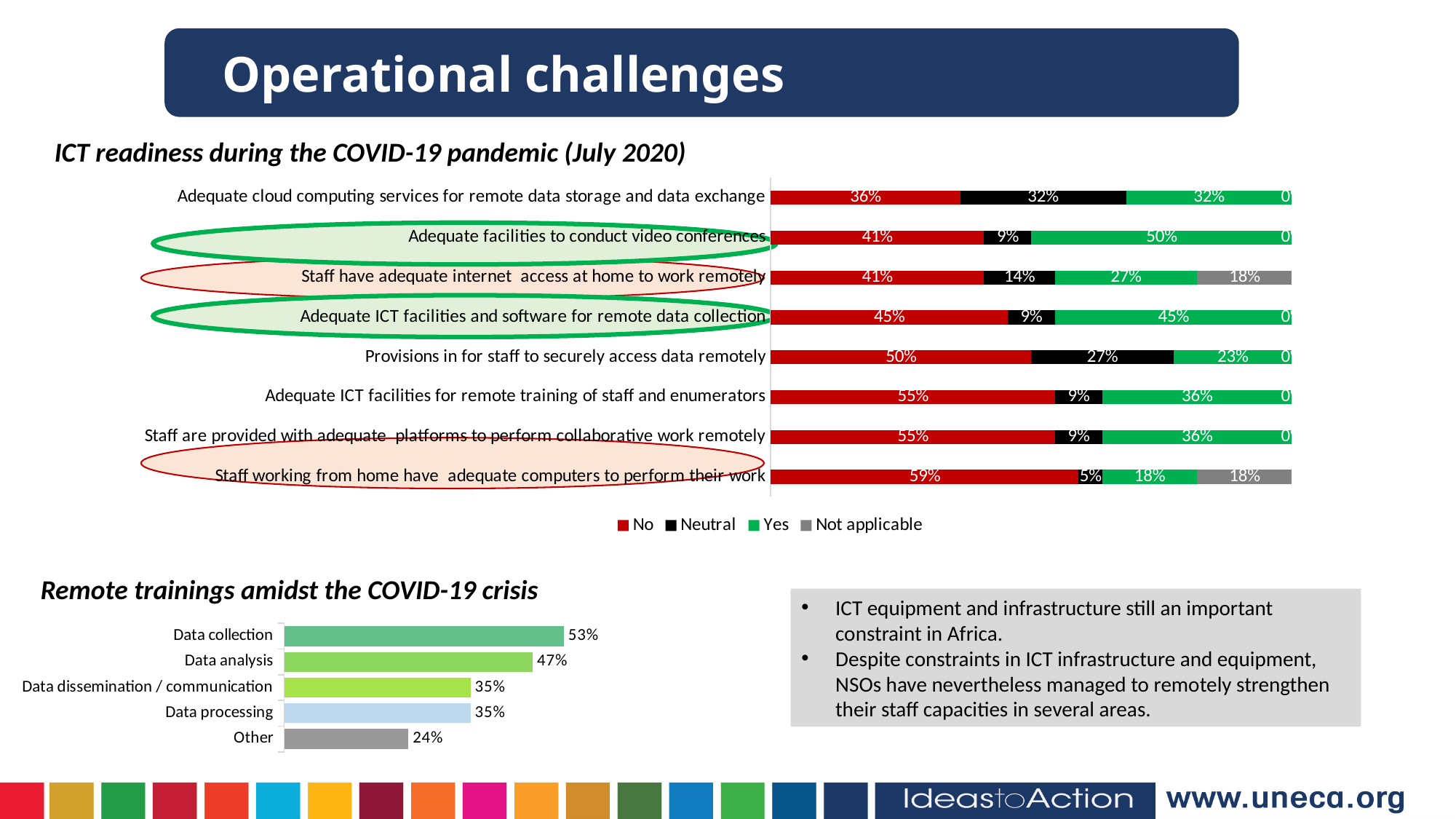
In the 'Remote trainings amidst the COVID-19 crisis' chart, what is the difference between 'Data collection' and 'Other'? 29% In the 'ICT readiness during the COVID-19 pandemic (July 2020)' chart, which colour represents 'Neutral'? Black In the 'ICT readiness during the COVID-19 pandemic (July 2020)' chart, how many series does the legend list? 4 In the 'ICT readiness during the COVID-19 pandemic (July 2020)' chart, how many categories are shown? 8 In the 'ICT readiness during the COVID-19 pandemic (July 2020)' chart, what is the 'Not applicable' value for 'Staff working from home have adequate computers to perform their work'? 18% In the 'Remote trainings amidst the COVID-19 crisis' chart, what is the value for 'Data analysis'? 47% In the 'Remote trainings amidst the COVID-19 crisis' chart, which category has the lowest value? Other In the 'ICT readiness during the COVID-19 pandemic (July 2020)' chart, which category has the highest 'No' value? Staff working from home have adequate computers to perform their work In the 'ICT readiness during the COVID-19 pandemic (July 2020)' chart, what is the difference between the 'No' and 'Yes' values for 'Provisions in for staff to securely access data remotely'? 27% In the 'ICT readiness during the COVID-19 pandemic (July 2020)' chart, what is the 'Yes' value for 'Adequate facilities to conduct video conferences'? 50% What kind of chart is the 'Remote trainings amidst the COVID-19 crisis' chart? Bar chart In the 'ICT readiness during the COVID-19 pandemic (July 2020)' chart, what is the 'No' value for 'Adequate cloud computing services for remote data storage and data exchange'? 36%